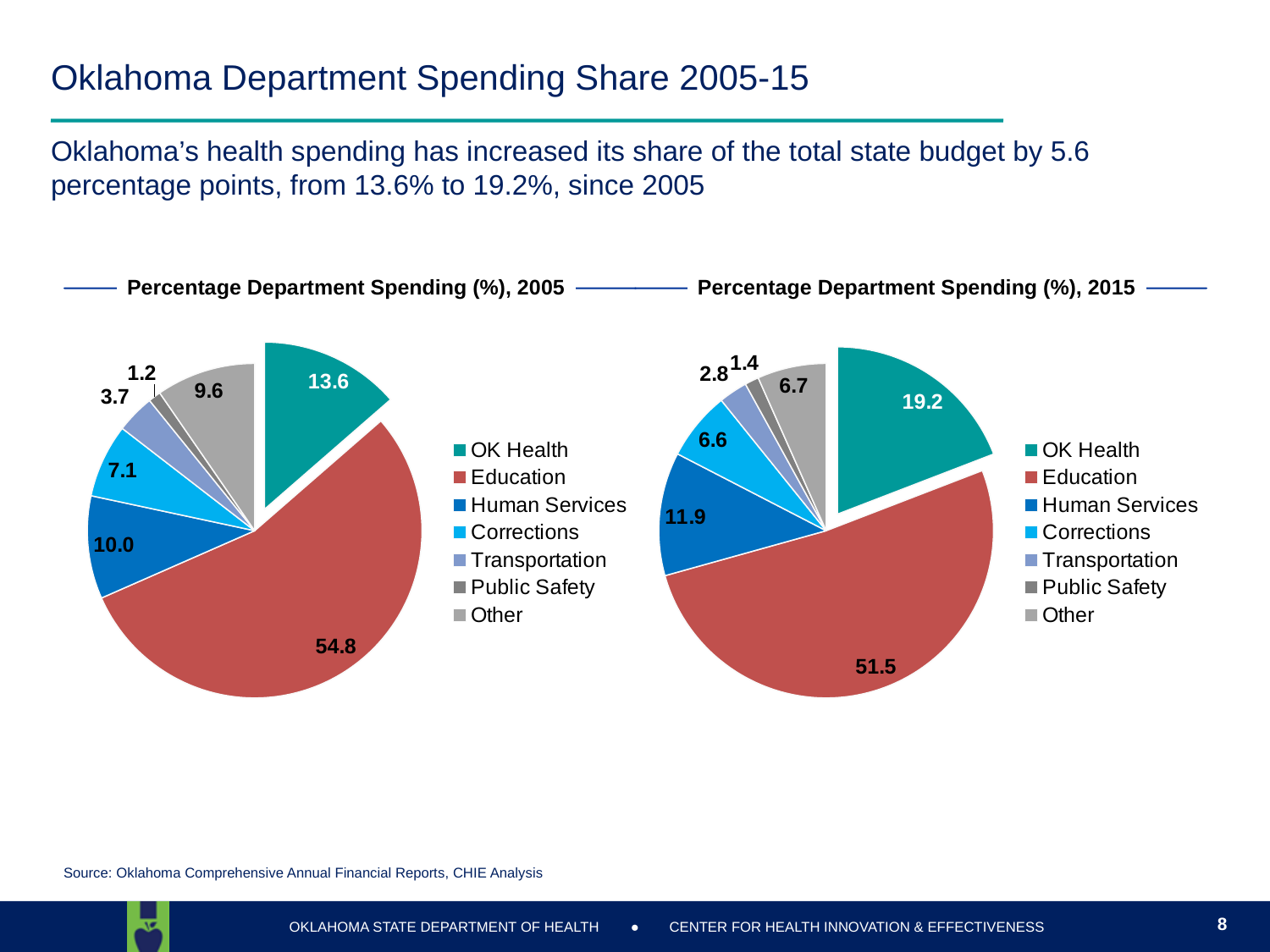
In the 'Percentage Department Spending (%), 2005' chart, which category has the largest share? Education What is the difference between the OK Health value in the 2015 chart and the OK Health value in the 2005 chart? 5.6 In the 'Percentage Department Spending (%), 2015' chart, what is the value for Education? 51.5 In the 'Percentage Department Spending (%), 2015' chart, what is the value for Transportation? 2.8 In the 'Percentage Department Spending (%), 2005' chart, what is the value for Human Services? 10.0 In the 'Percentage Department Spending (%), 2005' chart, what is the value for OK Health? 13.6 In the 'Percentage Department Spending (%), 2005' chart, what is the difference between the Education and Other values? 45.2 In the 'Percentage Department Spending (%), 2015' chart, which category has the smallest share? Public Safety How many categories does the 'Percentage Department Spending (%), 2005' chart show? 7 What type of chart is the 'Percentage Department Spending (%), 2015' chart? Pie chart In the 'Percentage Department Spending (%), 2015' chart, which is larger: Corrections or Other? Other In the 'Percentage Department Spending (%), 2005' chart, which colour represents Education? Red